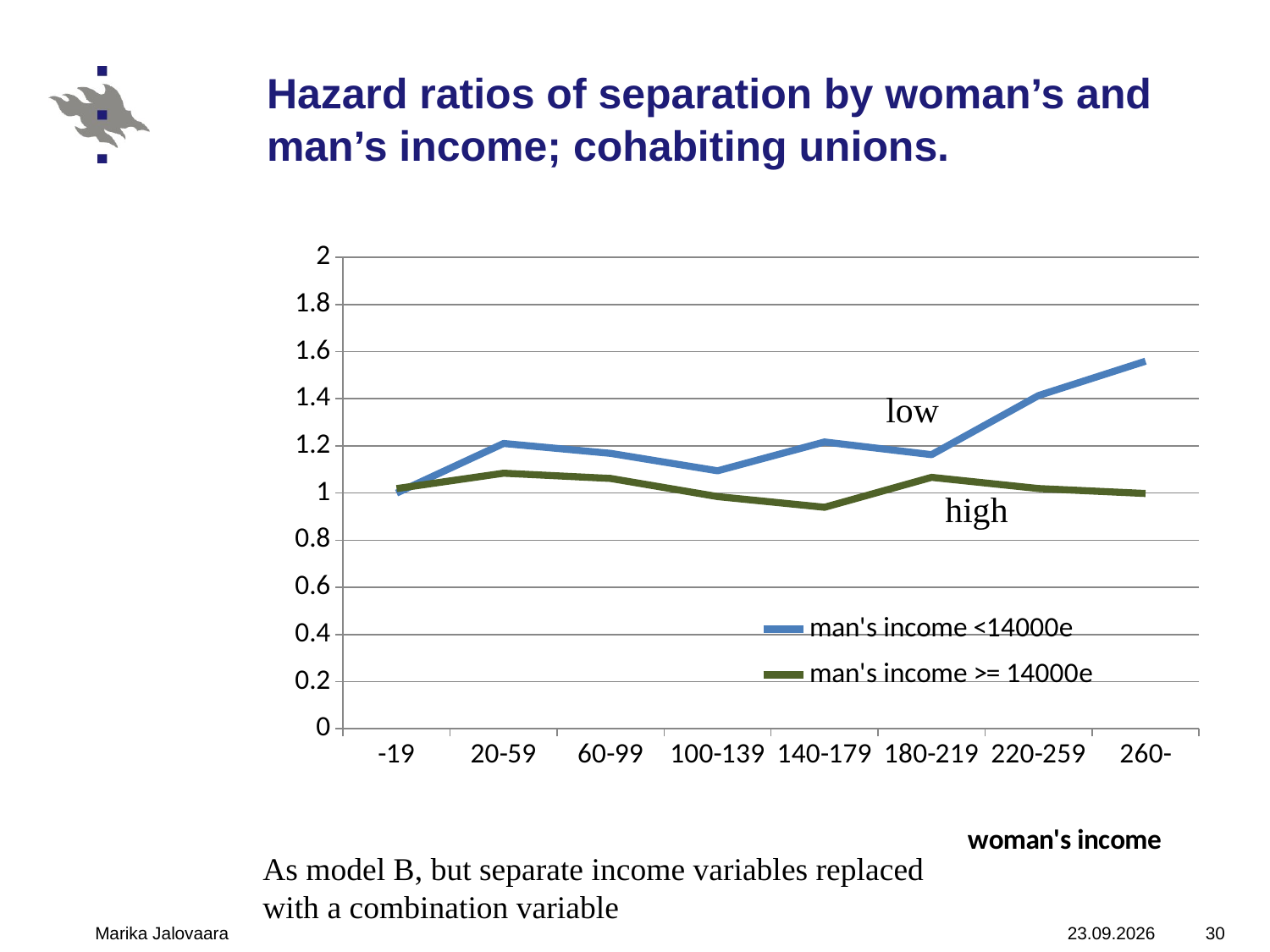
How many series does the legend list? 2 At woman's income 260-, which series has the higher hazard ratio: 'man's income <14000e' or 'man's income >= 14000e'? man's income <14000e Is the hazard ratio for 'man's income <14000e' at woman's income 20-59 greater or less than 1? greater What is the label of the x axis? woman's income Which woman's income category has the highest hazard ratio for the 'man's income <14000e' series? 260- Which woman's income category has the lowest hazard ratio for the 'man's income <14000e' series? -19 Does the 'man's income <14000e' line rise or fall from woman's income 180-219 to 260-? rise Which woman's income category has the lowest hazard ratio for the 'man's income >= 14000e' series? 140-179 What kind of chart is shown on the slide? line chart Is the hazard ratio for 'man's income <14000e' at woman's income 260- greater or less than 1.4? greater Is the hazard ratio for 'man's income >= 14000e' at woman's income 140-179 greater or less than 1? less How many woman's income categories are shown on the x axis? 8